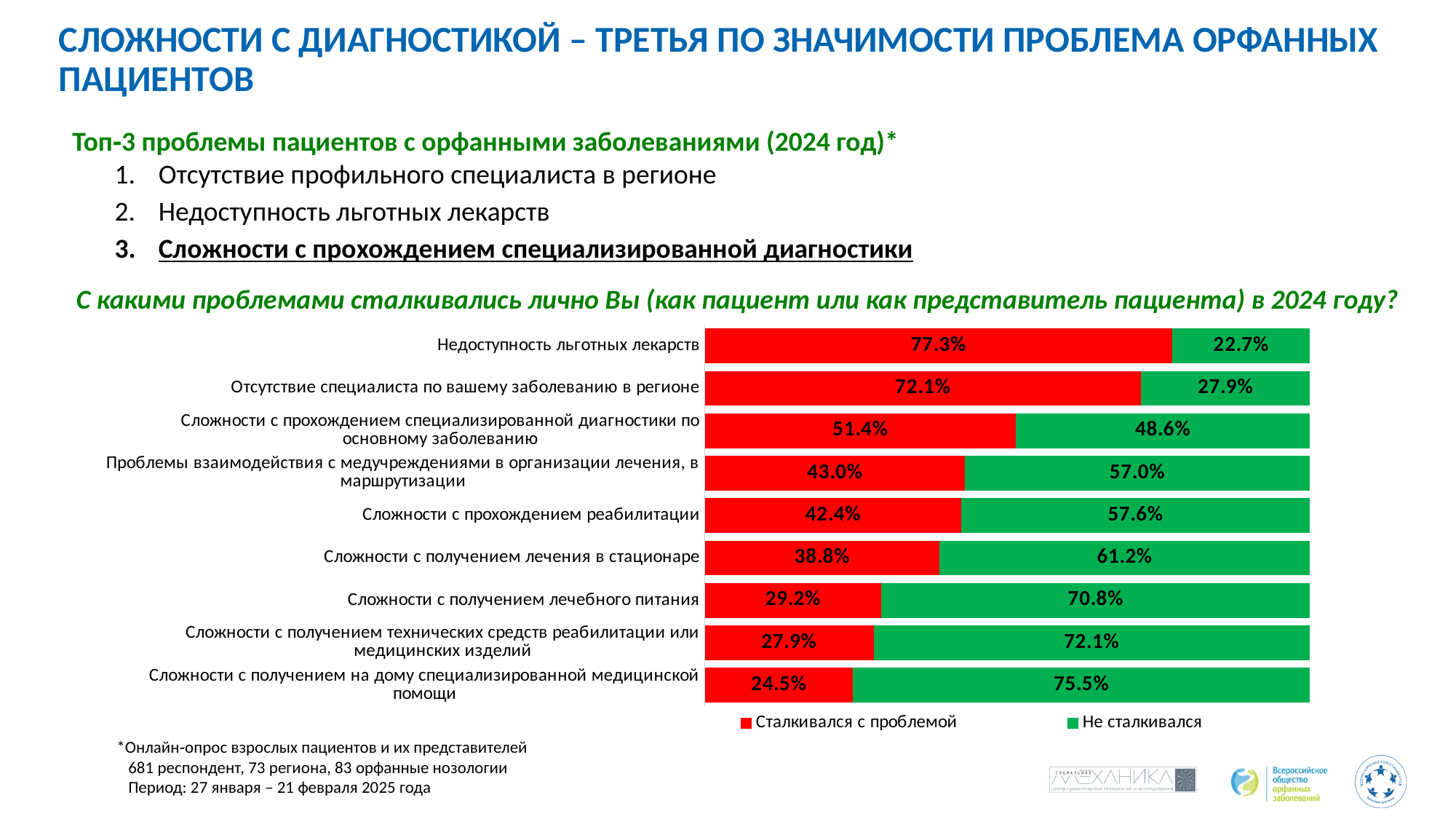
Which category has the lowest "Сталкивался с проблемой" value? Сложности с получением на дому специализированной медицинской помощи How many series does the chart legend list? 2 What share of respondents faced "Сложности с прохождением специализированной диагностики по основному заболеванию"? 51.4% Which colour represents "Не сталкивался" in the chart? Green What type of chart is shown on the slide? Stacked bar chart What percentage of respondents reported facing the problem "Недоступность льготных лекарств" (Сталкивался с проблемой)? 77.3% What is the "Не сталкивался" value for "Сложности с прохождением реабилитации"? 57.6% What is the total of the stacked bar for "Сложности с получением технических средств реабилитации или медицинских изделий"? 100.0% Which category has the highest "Сталкивался с проблемой" value? Недоступность льготных лекарств How many categories (problems) are shown in the chart? 9 What is the difference between the "Сталкивался с проблемой" values for "Недоступность льготных лекарств" and "Отсутствие специалиста по вашему заболеванию в регионе"? 5.2% Which is larger: the "Сталкивался с проблемой" value for "Сложности с получением лечения в стационаре" or for "Сложности с получением лечебного питания"? Сложности с получением лечения в стационаре